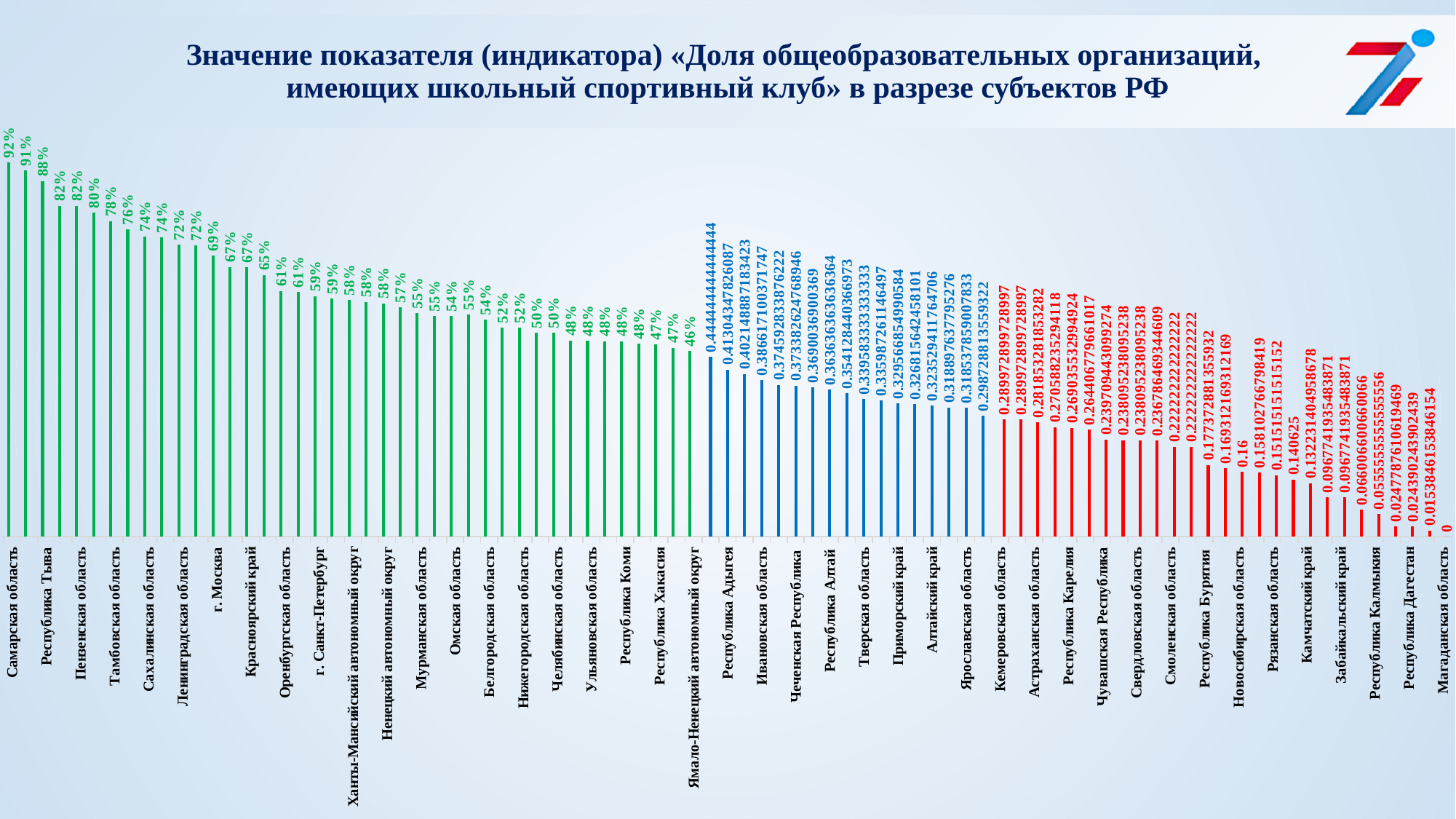
What colour are the bars with the highest values on the left of the chart? Green Which has a larger value, Самарская область or Новосибирская область? Самарская область How many different colours are used for the bars on the chart? 3 What is the value shown for Самарская область? 92% Do the values rise or fall moving from left to right along the x axis? Fall Which region has the highest value on the chart? Самарская область What is the value shown for Республика Тыва? 88% What is the value shown for Магаданская область? 0 What is the value shown for Новосибирская область? 0.16 What is the difference between the values for Самарская область and Республика Тыва? 4% What kind of chart is shown on the slide? Bar chart Which region has the lowest value on the chart? Магаданская область